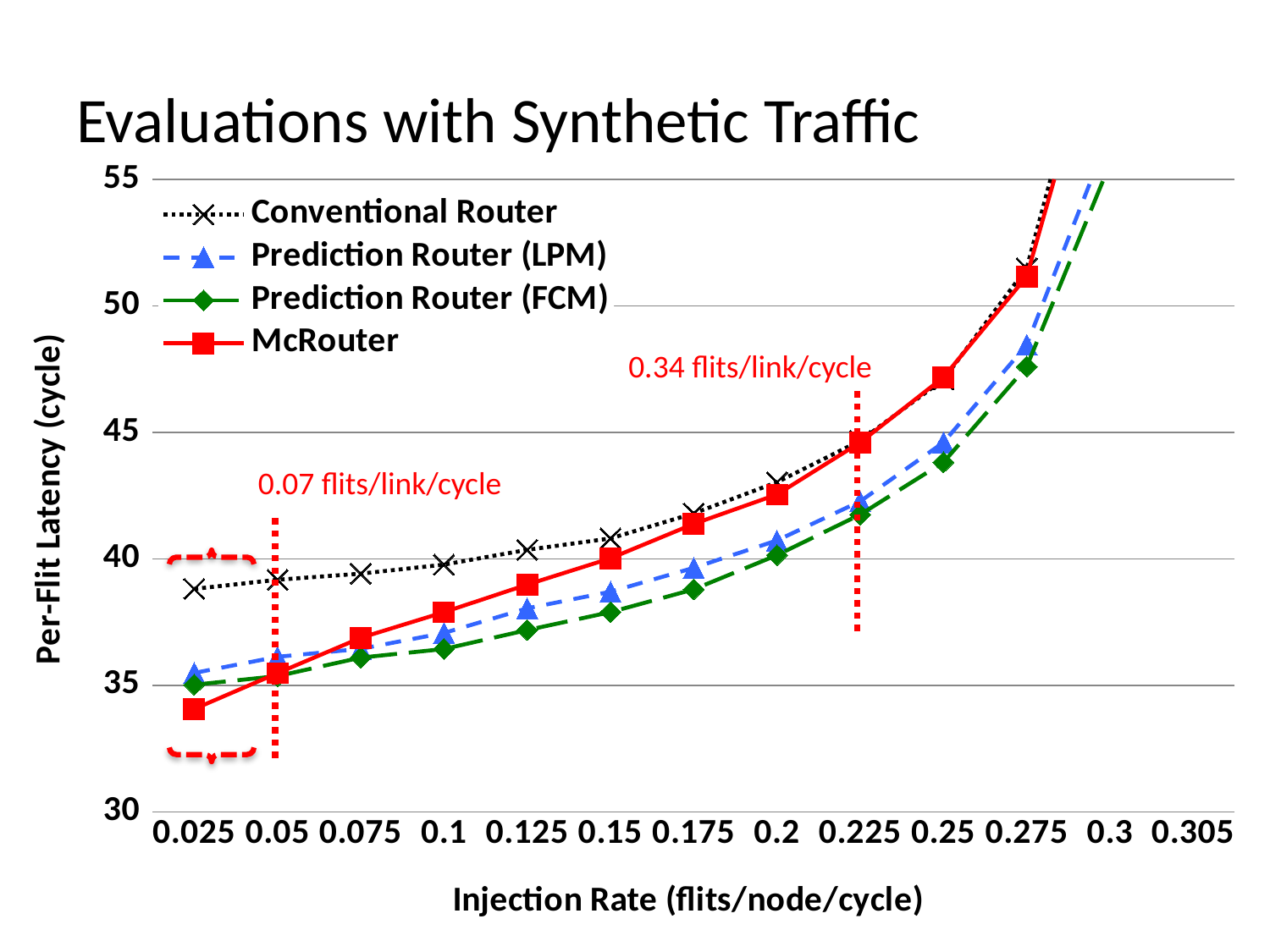
What is the title of the vertical axis? Per-Flit Latency (cycle) What kind of chart is shown on the slide? line chart What are the four series named in the legend? Conventional Router, Prediction Router (LPM), Prediction Router (FCM), McRouter Is the Prediction Router (FCM) value at injection rate 0.15 greater or less than 40? less Do the latency values rise or fall as the injection rate increases along the x axis? rise Which series has the lowest latency at injection rate 0.1? Prediction Router (FCM) Is the McRouter value at injection rate 0.025 greater or less than 35? less Which series has the highest latency at injection rate 0.1? Conventional Router Is the Conventional Router value at injection rate 0.2 greater or less than 40? greater How many series does the legend list? 4 At injection rate 0.025, which has the higher latency: Conventional Router or McRouter? Conventional Router